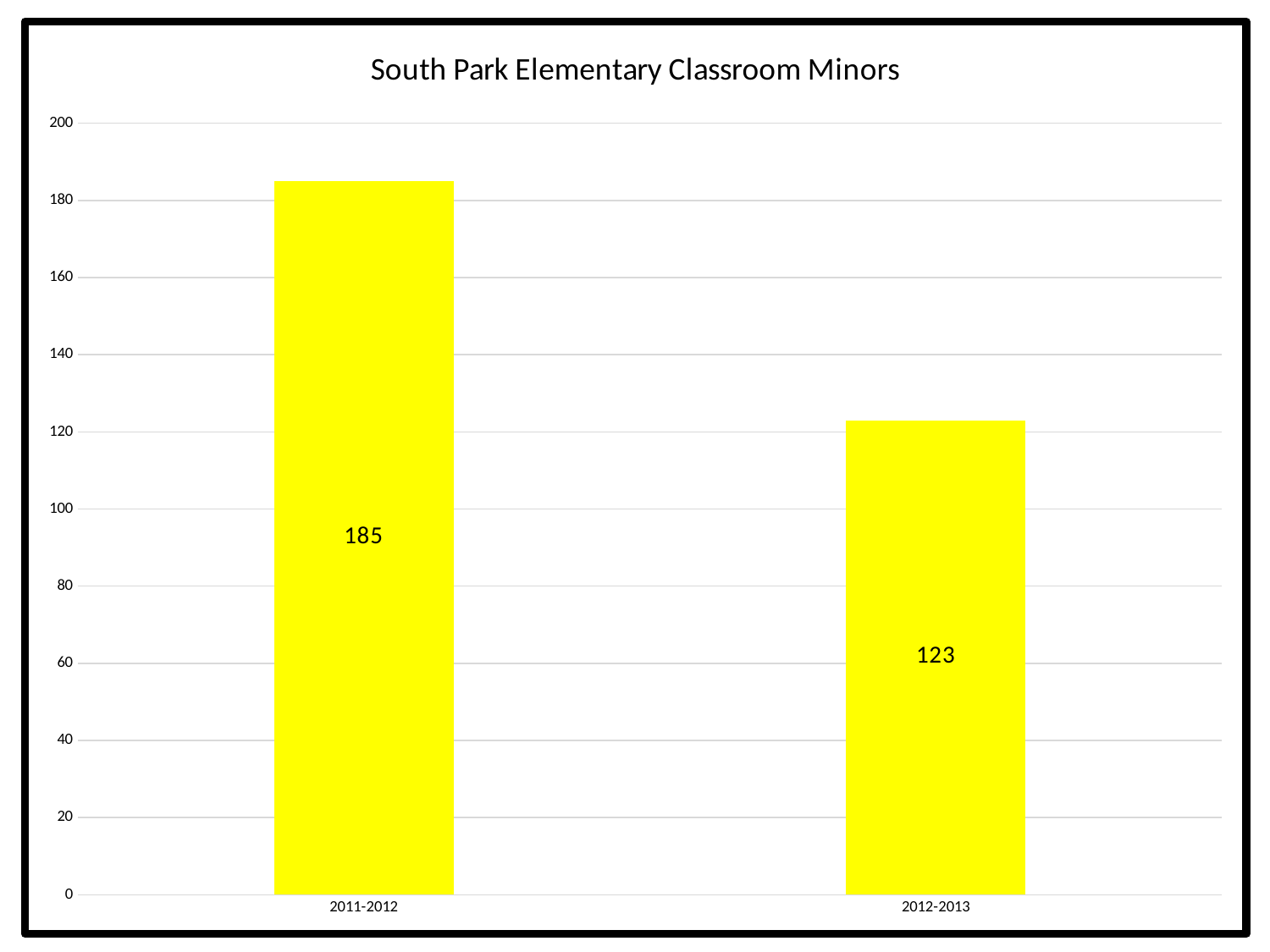
Do the values rise or fall from 2011-2012 to 2012-2013? fall Is the value for 2011-2012 greater or less than 160? greater What is the difference between the values for 2011-2012 and 2012-2013? 62 Which school year has the highest number of classroom minors? 2011-2012 Is the value for 2012-2013 greater or less than 140? less What is the value for 2011-2012? 185 What is the value for 2012-2013? 123 How many categories are shown on the x axis? 2 Which school year has the lowest number of classroom minors? 2012-2013 Which is larger, the value for 2011-2012 or the value for 2012-2013? 2011-2012 What kind of chart is shown on the slide? bar chart What is the title of the chart? South Park Elementary Classroom Minors